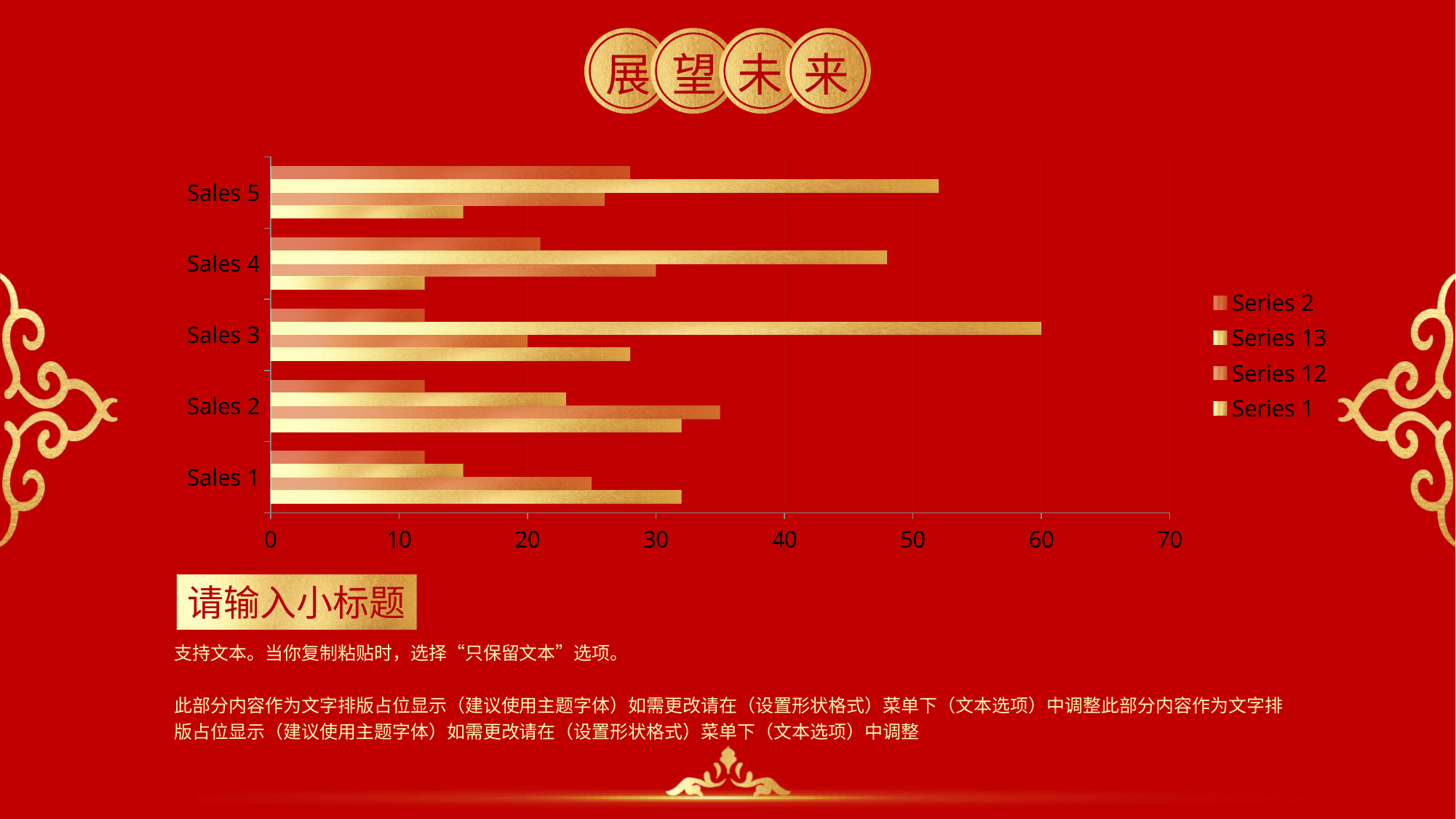
Which category contains the longest bar in the chart? Sales 3 What kind of chart is shown on the slide? Bar chart How many series does the chart legend list? 4 Is the shortest bar for Sales 4 greater or less than 20? less What is the maximum value shown on the horizontal axis of the chart? 70 What are the series names listed in the chart legend? Series 2, Series 13, Series 12, Series 1 Which is longer: the longest bar for Sales 3 or the longest bar for Sales 5? Sales 3 Which is longer: the longest bar for Sales 4 or the longest bar for Sales 2? Sales 4 How many categories are shown on the vertical axis of the chart? 5 Is the longest bar for Sales 1 greater or less than 40? less Is the longest bar for Sales 3 greater or less than 50? greater